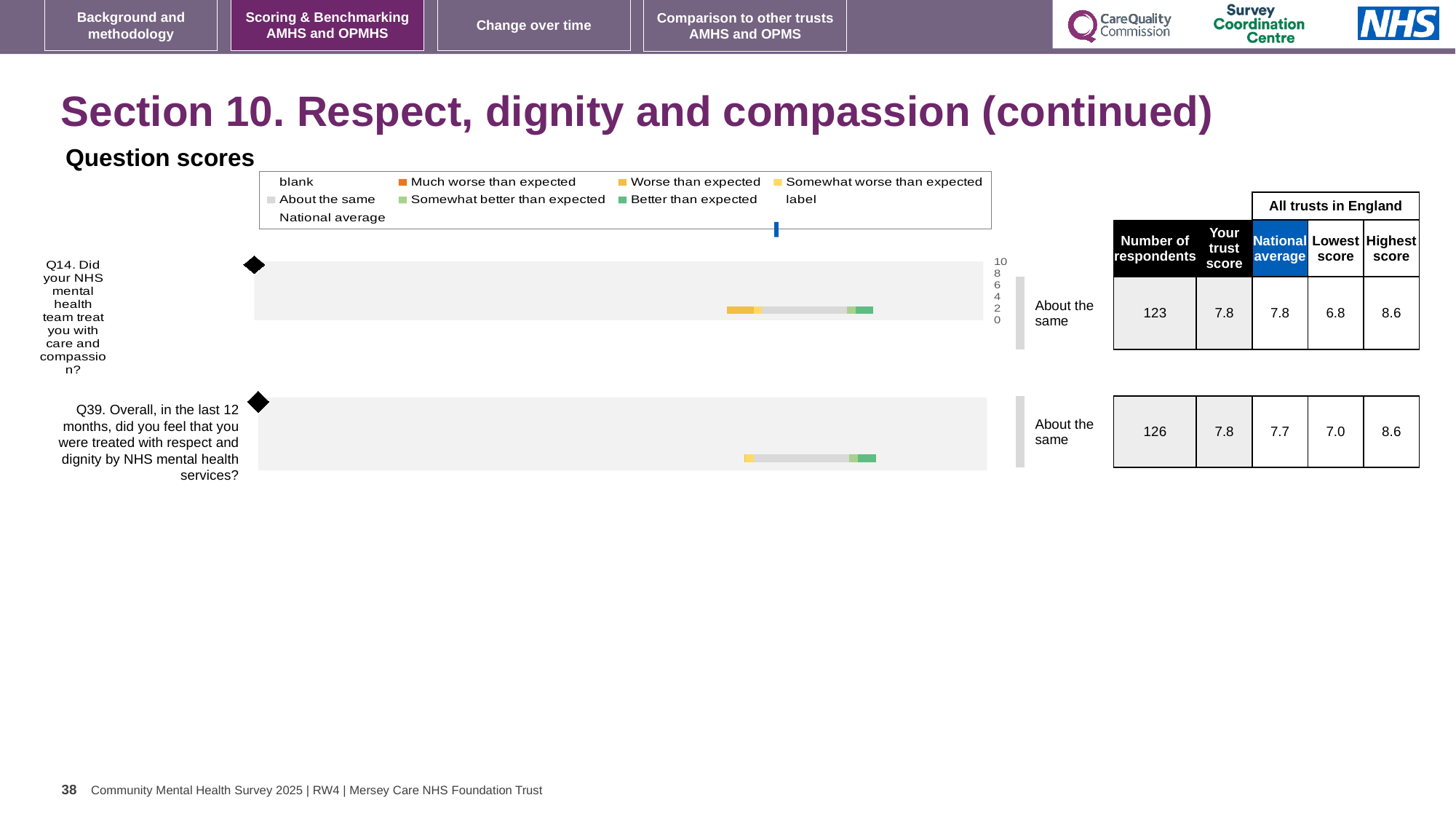
In the table beside the chart, what is the national average for Q39? 7.7 For Q14, what is the difference between the highest score and the lowest score across all trusts in England? 1.8 In the table beside the chart, what is the trust score for Q14? 7.8 What is the highest value shown on the score axis of the chart? 10 In the table beside the chart, what is the highest score across all trusts for Q39? 8.6 Which question had more respondents, Q14 or Q39? Q39 What benchmark category label is shown next to the bar for Q39? About the same For Q39, which is larger, the trust score or the national average? the trust score In the table beside the chart, how many respondents answered Q14? 123 What benchmark category label is shown next to the bar for Q14? About the same How many questions are plotted in the question scores chart? 2 What kind of chart is used to show the question scores for Q14 and Q39? bar chart